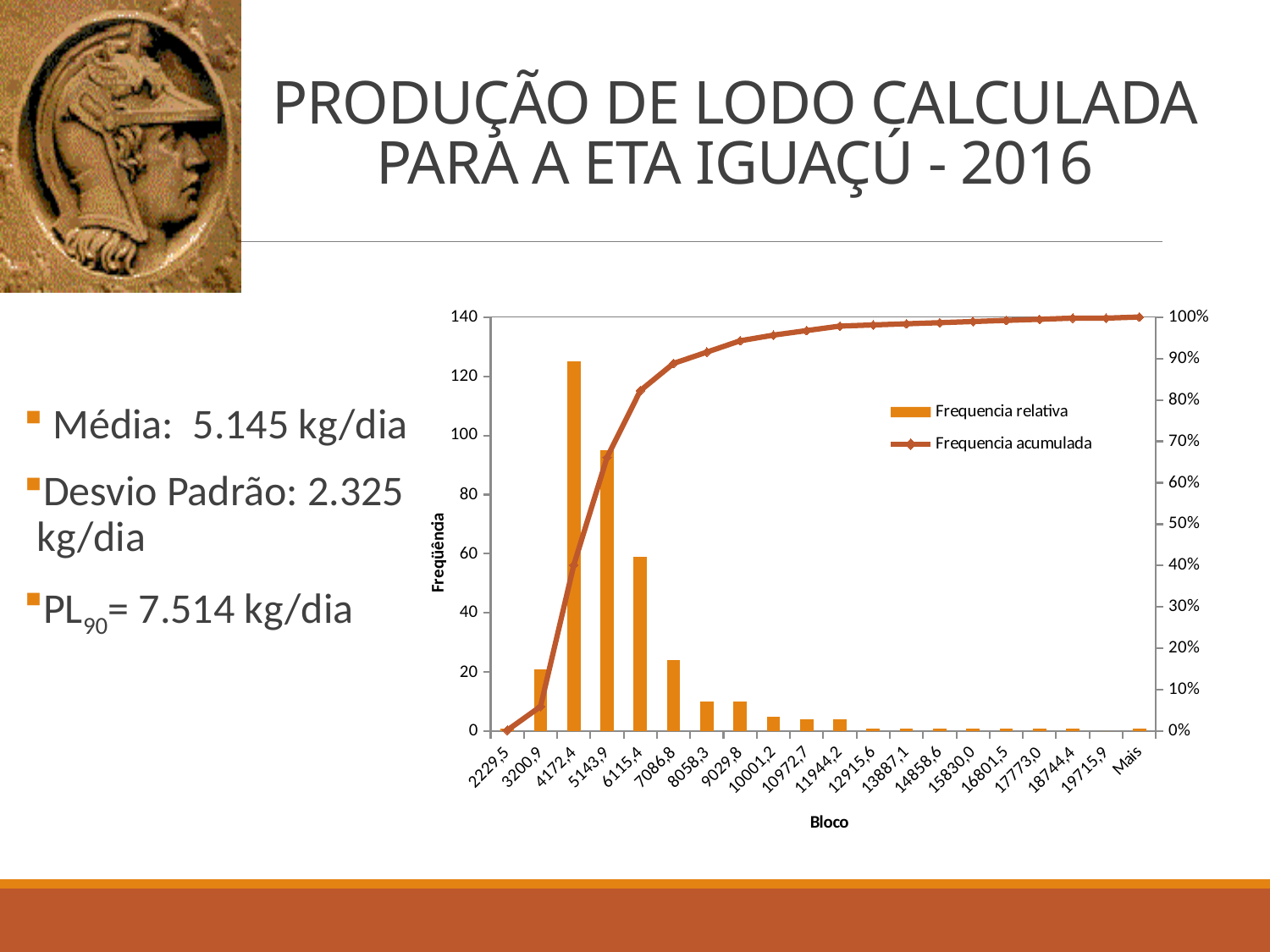
Does the Frequencia acumulada line rise or fall along the x axis? rise Is the Frequencia relativa bar for bloco 5143,9 greater or less than 80? greater What kind of chart is shown on the slide? A bar chart combined with a line chart Is the Frequencia relativa bar for bloco 8058,3 greater or less than 20? less How many categories (blocos) are shown on the x axis? 20 Which bloco has the highest Frequencia relativa bar? 4172,4 Is the Frequencia relativa bar for bloco 4172,4 greater or less than 120? greater How many series does the legend list? 2 Which bloco has the larger Frequencia relativa bar, 5143,9 or 6115,4? 5143,9 What is the title of the x axis of the chart? Bloco